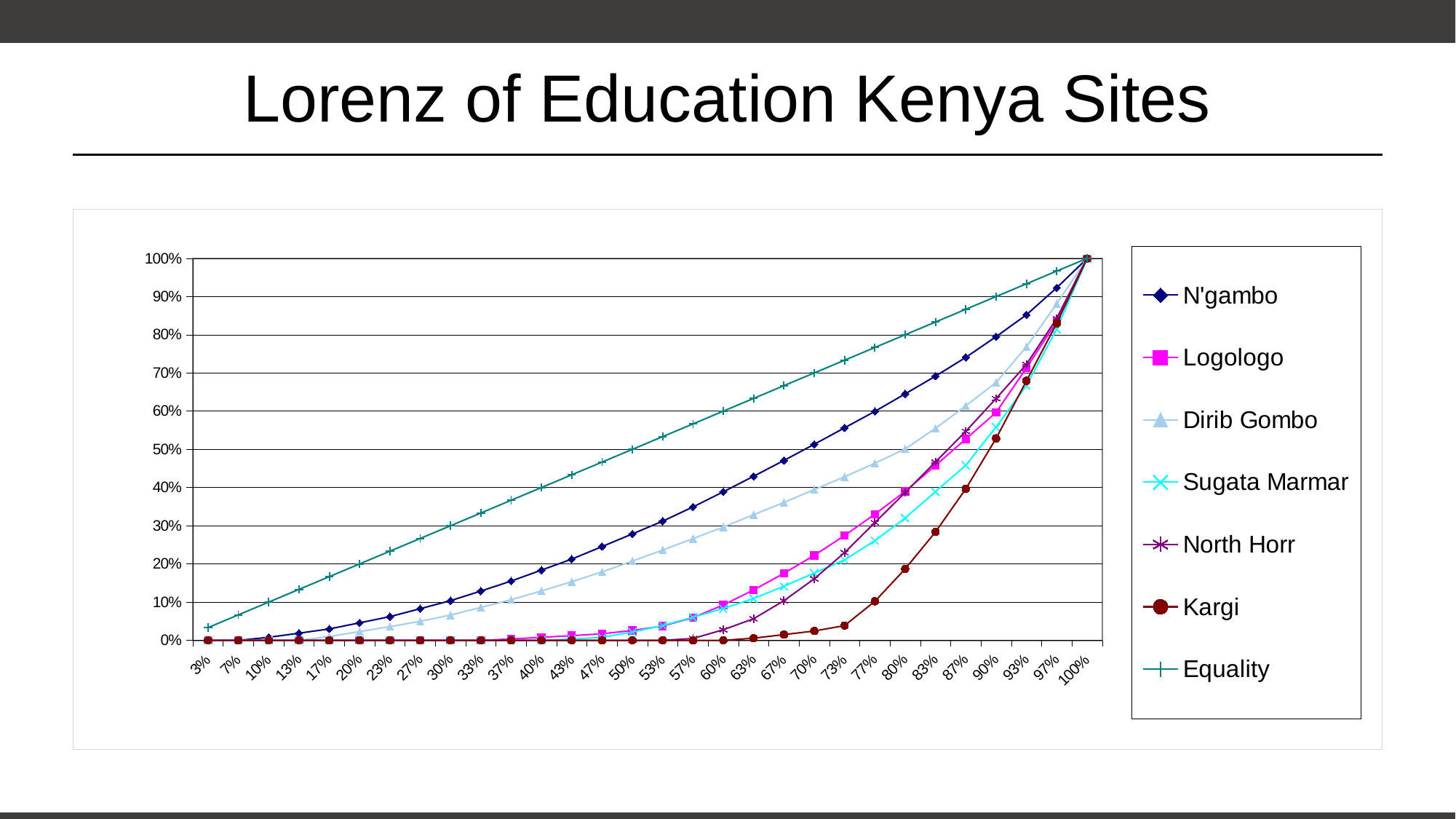
Which series has the lowest value at the 80% category? Kargi How many series does the legend list? 7 What is the value of the Equality series at the 50% category? 50% Is the value for N'gambo at the 80% category greater or less than 60%? greater What kind of chart is shown on the slide? line chart Is the value for N'gambo at the 50% category greater or less than 30%? less What is the title of the slide containing the chart? Lorenz of Education Kenya Sites How many categories are shown on the x axis? 30 Which series is drawn as a straight diagonal line from the bottom left to the top right? Equality At the 50% category, which is larger: N'gambo or Kargi? N'gambo What is the value of the Kargi series at the 100% category? 100%